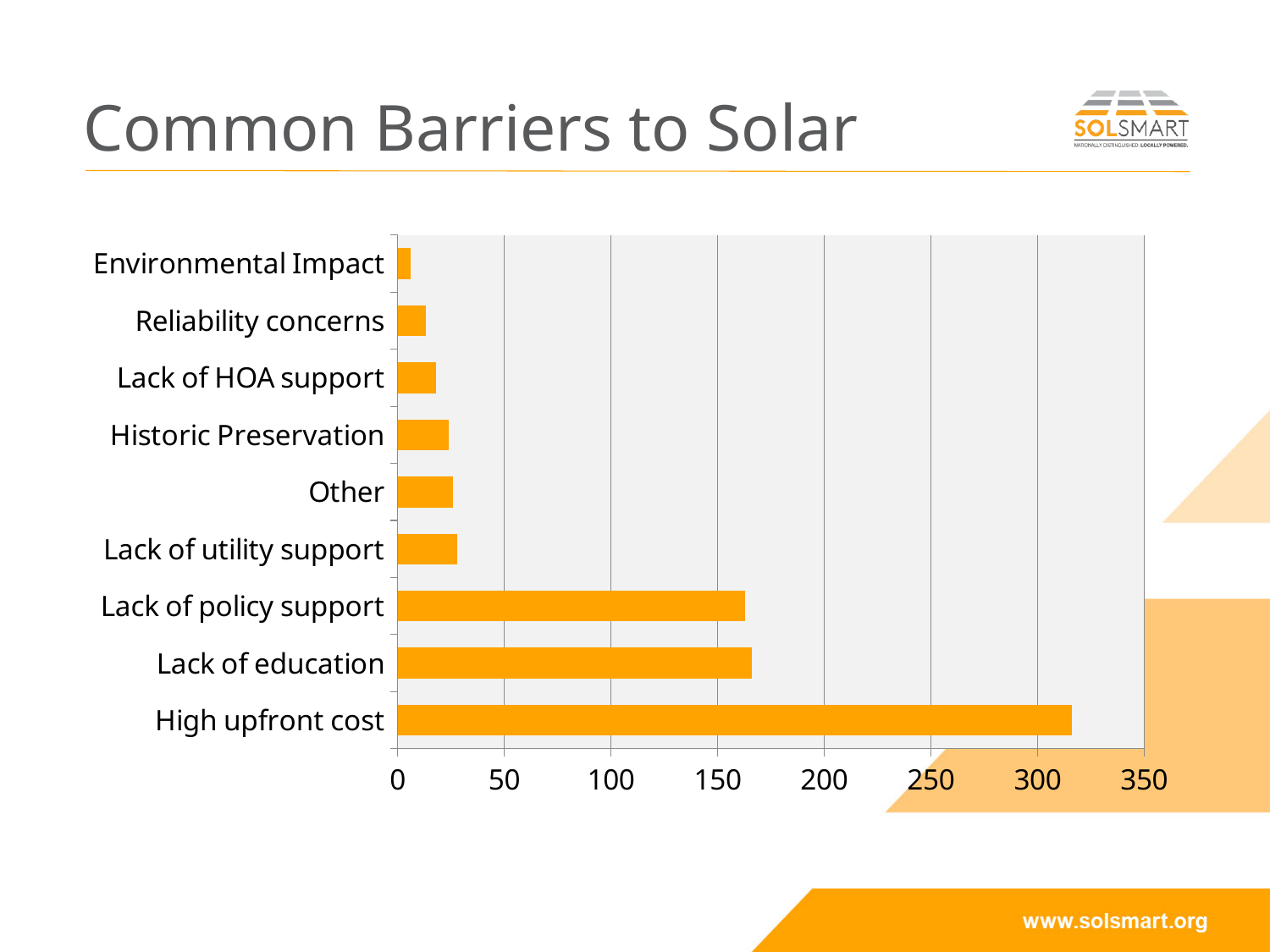
Is the value for Lack of education greater or less than 150? greater Is the value for Lack of utility support greater or less than 50? less What kind of chart is shown on the slide? bar chart Which is larger, the value for Lack of policy support or the value for Lack of HOA support? Lack of policy support Which barrier has the lowest value in the chart? Environmental Impact Which is larger, the value for High upfront cost or the value for Lack of education? High upfront cost What is the title of the slide containing the chart? Common Barriers to Solar What is the highest value shown on the horizontal axis of the chart? 350 Is the value for Lack of policy support greater or less than 200? less Which barrier has the highest value in the chart? High upfront cost How many barriers (categories) are plotted in the chart? 9